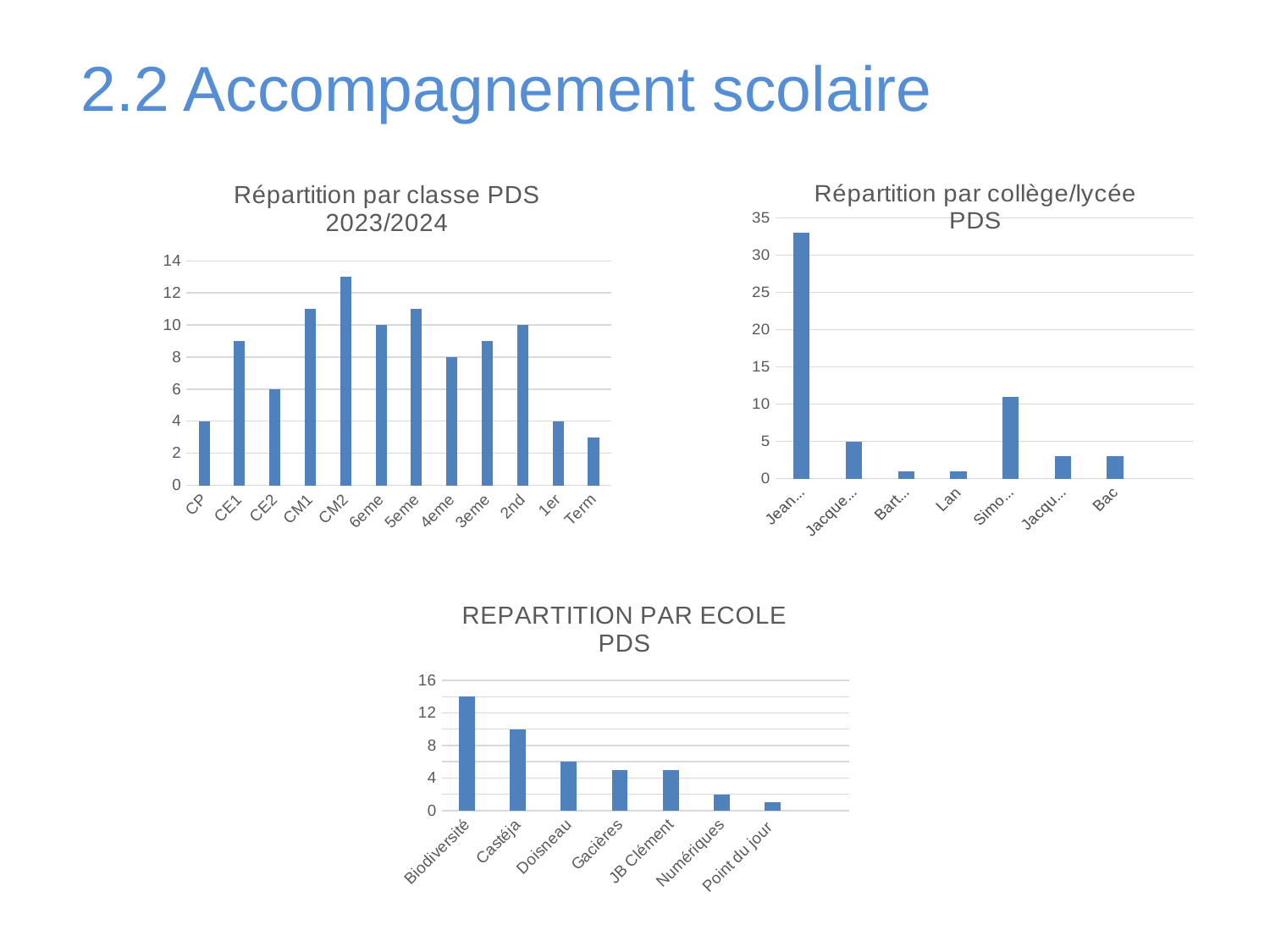
In the chart titled 'REPARTITION PAR ECOLE PDS', which school has the lowest value? Point du jour In the chart titled 'Répartition par classe PDS 2023/2024', what is the value for 6eme? 10 In the chart titled 'Répartition par classe PDS 2023/2024', which class has the lowest value? Term In the chart titled 'REPARTITION PAR ECOLE PDS', which school has the highest value? Biodiversité In the chart titled 'Répartition par classe PDS 2023/2024', what is the value for CP? 4 How many classes are shown in the chart titled 'Répartition par classe PDS 2023/2024'? 12 In the chart titled 'REPARTITION PAR ECOLE PDS', is the value for Biodiversité greater or less than 12? greater What kind of chart is 'Répartition par classe PDS 2023/2024'? Bar chart In the chart titled 'Répartition par classe PDS 2023/2024', which class has the highest value? CM2 In the chart titled 'Répartition par collège/lycée PDS', is the value for Bac greater or less than 5? less In the chart titled 'Répartition par classe PDS 2023/2024', what is the difference between the values for 6eme and CP? 6 How many categories are shown in the chart titled 'Répartition par collège/lycée PDS'? 7